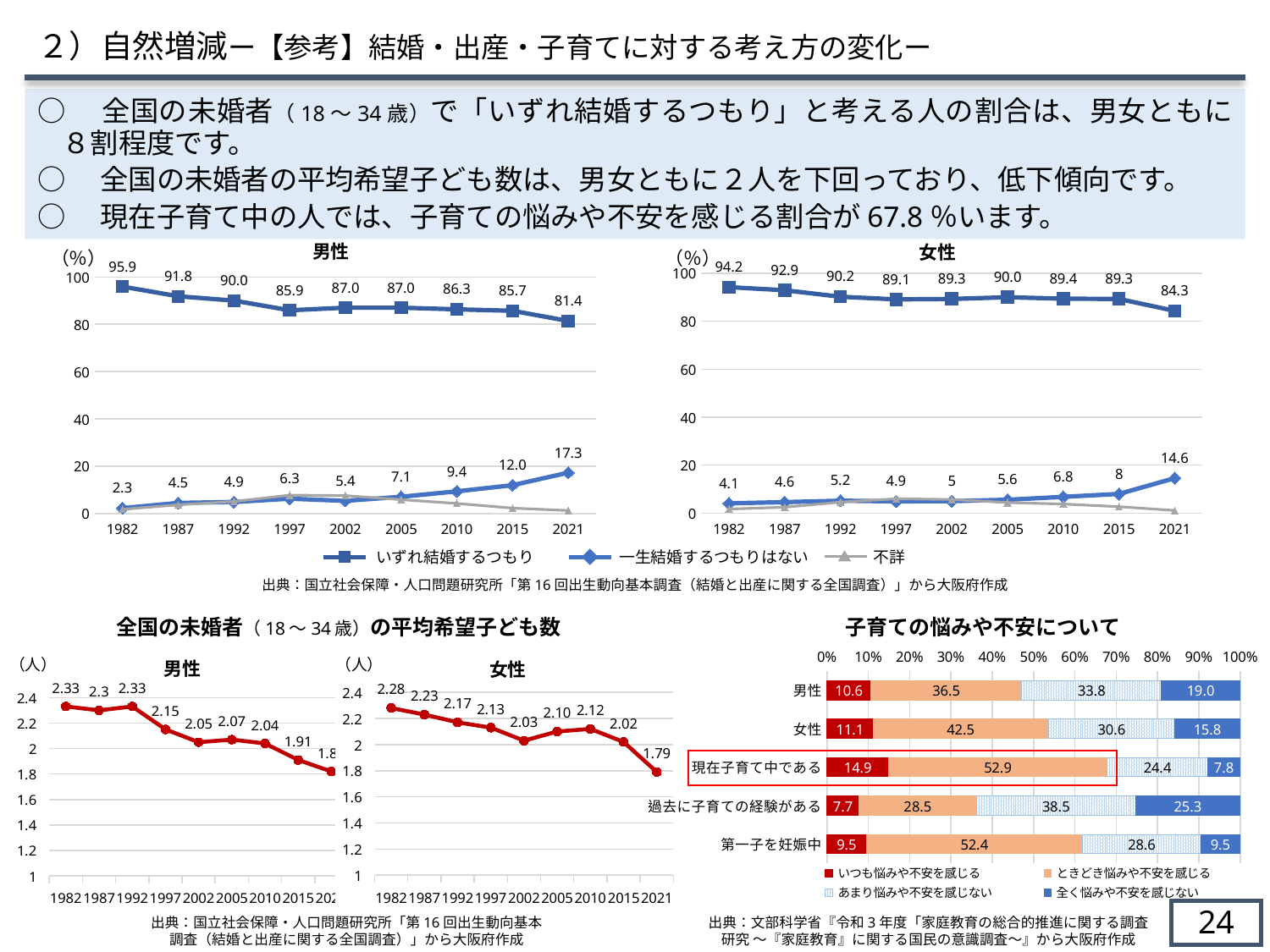
In the top-right 女性 line chart, what is the value of 一生結婚するつもりはない in 2021? 14.6 In the 子育ての悩みや不安について chart, how many categories are shown on the vertical axis? 5 In the 子育ての悩みや不安について chart, what is the いつも悩みや不安を感じる value for 現在子育て中である? 14.9 How many series does the legend list for the top 男性 and 女性 line charts? 3 In the top-right 女性 line chart, does the 一生結婚するつもりはない series rise or fall from 1982 to 2021? rise In the top-left 男性 line chart, what is the difference between the いずれ結婚するつもり values for 1982 and 2021? 14.5 In the bottom-left 男性 chart of 平均希望子ども数, what is the value for 2015? 1.91 What kind of chart is the 子育ての悩みや不安について chart? stacked bar chart In the bottom-left 女性 chart of 平均希望子ども数, in which year is the value lowest? 2021 In the top-left 男性 line chart, in which year is いずれ結婚するつもり highest? 1982 In the 子育ての悩みや不安について chart, which category has the larger ときどき悩みや不安を感じる value, 男性 or 女性? 女性 In the top-left 男性 line chart, what is the value of いずれ結婚するつもり in 2021? 81.4